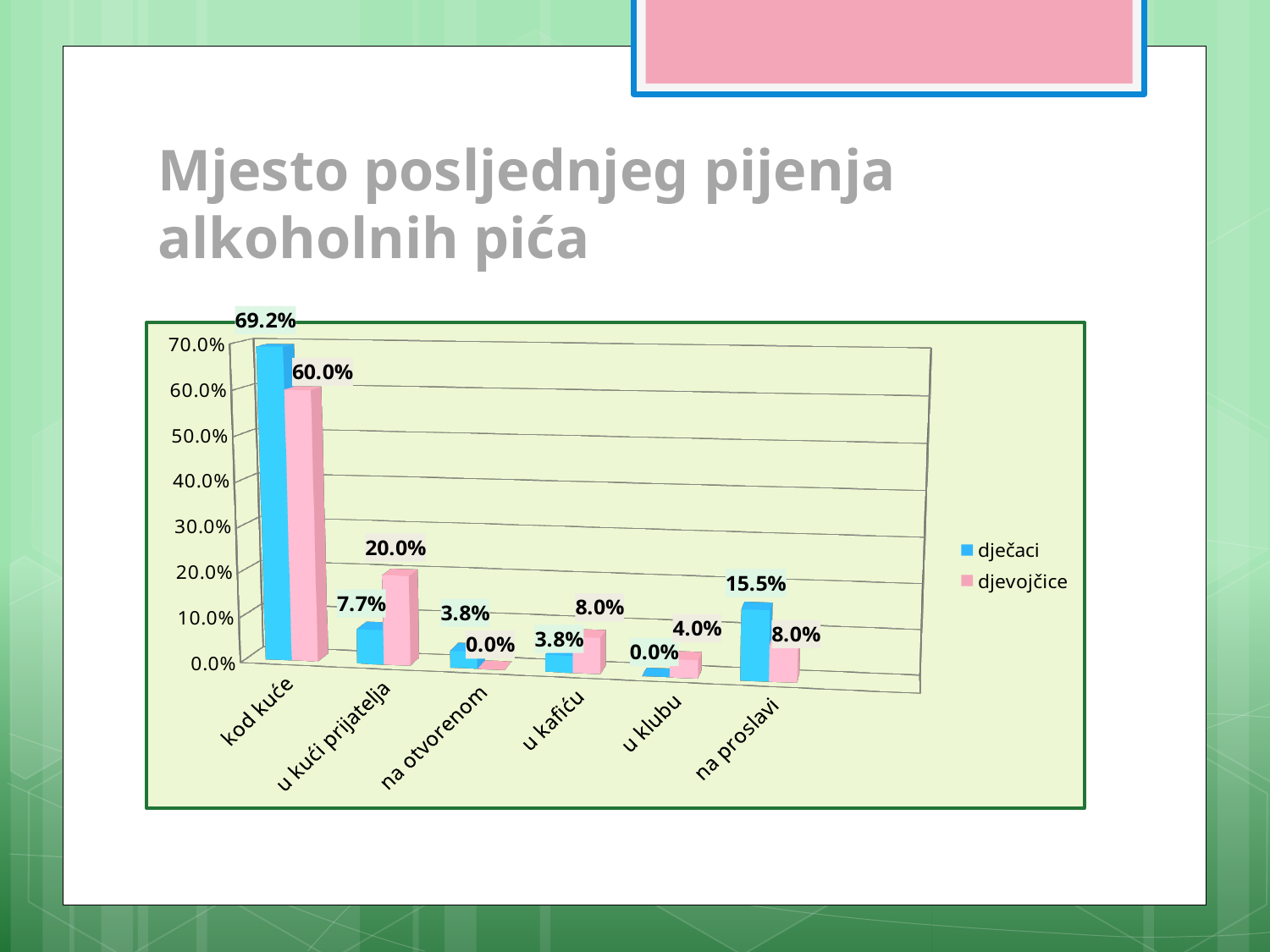
How many series does the legend list? 2 What is the value for djevojčice at u klubu? 4.0% How many categories are shown on the x axis? 6 What kind of chart is shown on the slide? bar chart What is the difference between the djevojčice and dječaci values at u kući prijatelja? 12.3% What is the value for dječaci at na proslavi? 15.5% What is the difference between the dječaci and djevojčice values at kod kuće? 9.2% What is the value for djevojčice at u kući prijatelja? 20.0% Which category has the highest value for djevojčice? kod kuće What is the value for dječaci at kod kuće? 69.2% At na proslavi, which series has the larger value, dječaci or djevojčice? dječaci Which category has the lowest value for dječaci? u klubu